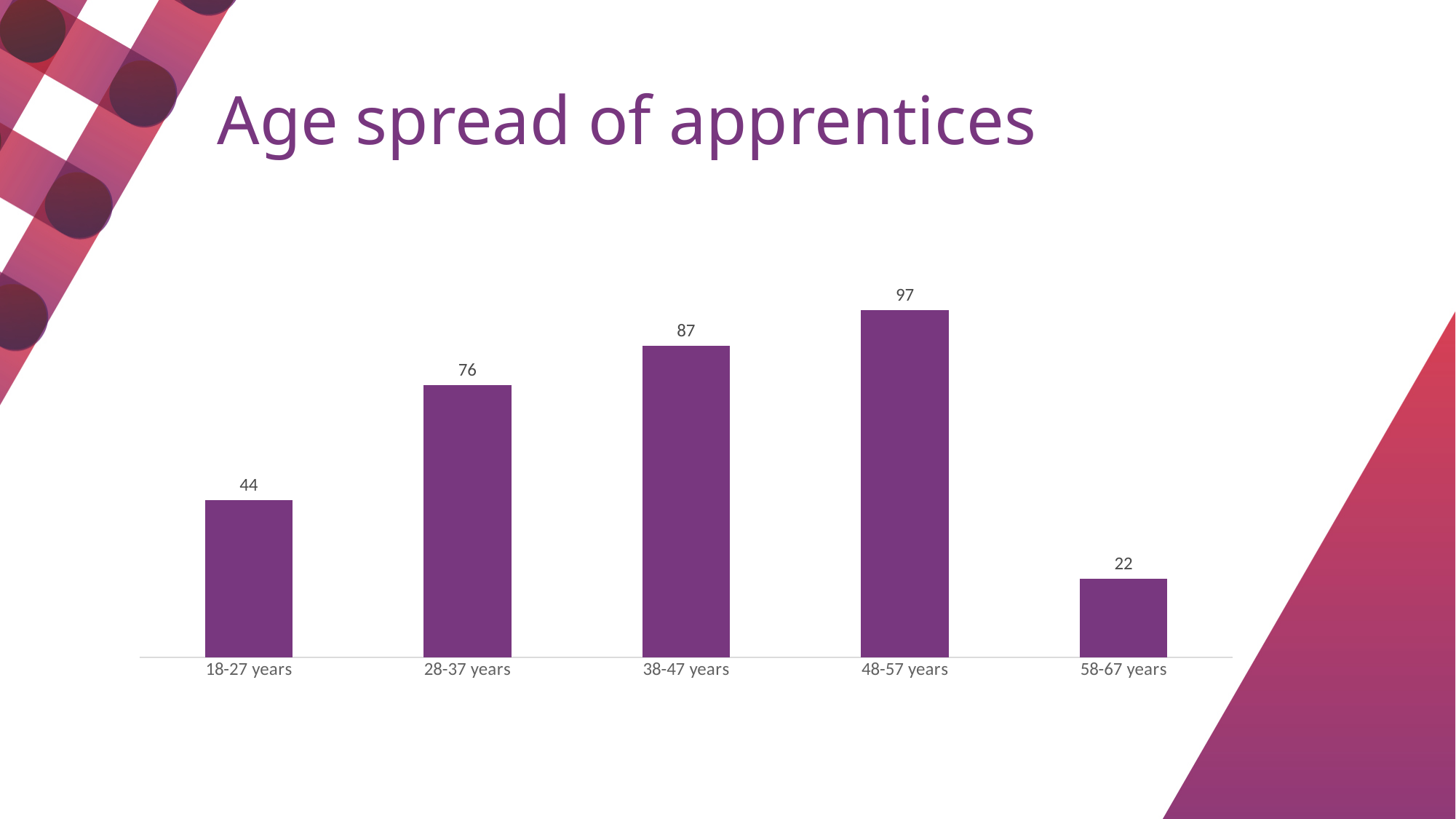
What is the value for 28-37 years? 76 What kind of chart is shown on the slide? Bar chart Which is larger, the value for 28-37 years or the value for 38-47 years? 38-47 years How many age groups are shown in the chart? 5 What is the value for 58-67 years? 22 What is the value for 38-47 years? 87 What is the difference between the values for 48-57 years and 18-27 years? 53 What is the value for 18-27 years? 44 Which age group has the highest value? 48-57 years What is the value for 48-57 years? 97 What is the title of the slide? Age spread of apprentices Which age group has the lowest value? 58-67 years